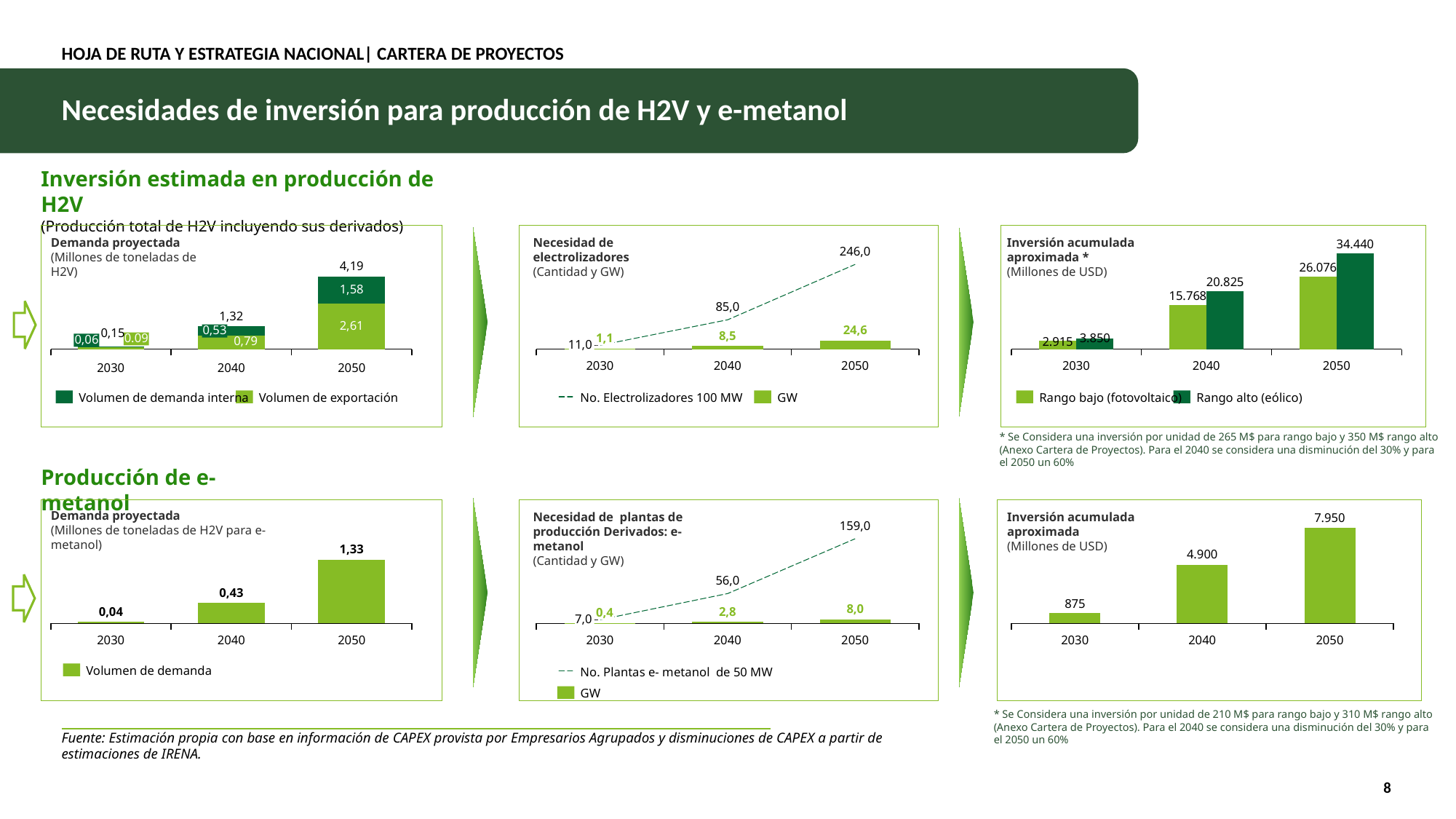
In the bottom-right chart (Inversión acumulada aproximada, Millones de USD), what is the difference between the 2050 and 2040 values? 3.050 In the bottom-middle chart (Necesidad de plantas de producción Derivados: e-metanol), what is the number of plantas of 50 MW in 2040? 56,0 In the top-right chart (Inversión acumulada aproximada, Millones de USD), what is the difference between Rango alto (eólico) and Rango bajo (fotovoltaico) in 2050? 8.364 In the bottom-left chart (Demanda proyectada for e-metanol), what is the Volumen de demanda for 2040? 0,43 In the bottom-left chart (Demanda proyectada for e-metanol), do the values rise or fall from 2030 to 2050? rise In the top-left chart (Demanda proyectada, Millones de toneladas de H2V), how many series does the legend list? 2 In the top-left chart (Demanda proyectada, Millones de toneladas de H2V), what is the value of Volumen de exportación for 2050? 2,61 What kind of chart is the bottom-right chart (Inversión acumulada aproximada, Millones de USD)? bar chart In the top-middle chart (Necesidad de electrolizadores), what is the GW value for 2040? 8,5 In the top-right chart (Inversión acumulada aproximada, Millones de USD), which year has the highest Rango bajo (fotovoltaico) value? 2050 In the top-left chart (Demanda proyectada, Millones de toneladas de H2V), what is the total of the stacked bar for 2040? 1,32 In the top-middle chart (Necesidad de electrolizadores), what is the number of electrolizadores of 100 MW in 2050? 246,0